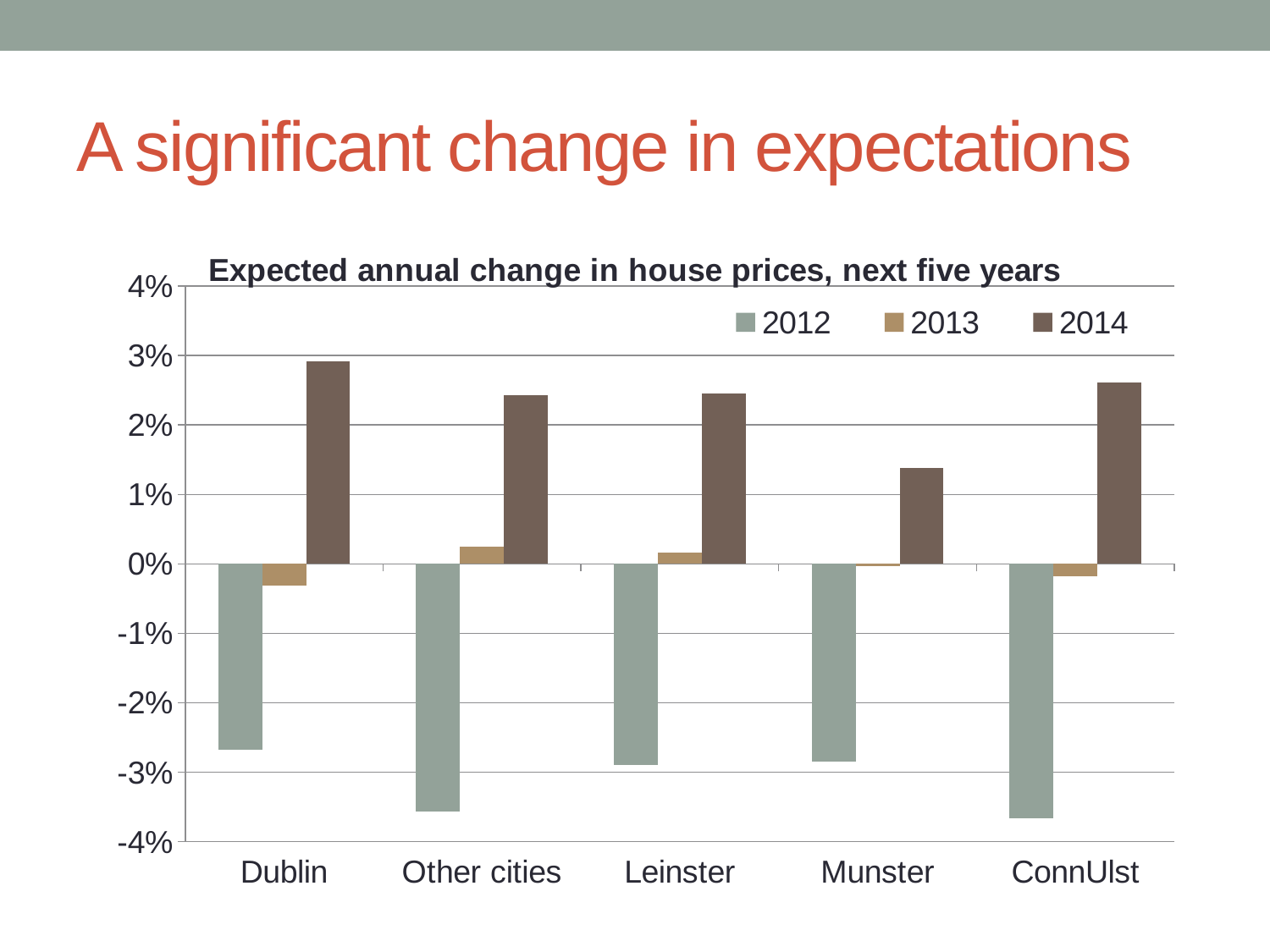
Which category has the highest value for the 2014 series? Dublin Which category has the lowest value for the 2014 series? Munster Which series is shown in the darkest brown colour in the legend? 2014 Is the 2012 value for Other cities greater or less than -3%? less How many categories are shown on the x axis? 5 Is the 2014 value for ConnUlst greater or less than 2%? greater Is the 2012 value for Dublin greater or less than -3%? greater Which is larger, the 2014 value for Dublin or the 2014 value for Munster? Dublin What kind of chart is shown on the slide? bar chart What is the title of the chart? Expected annual change in house prices, next five years How many series does the legend list? 3